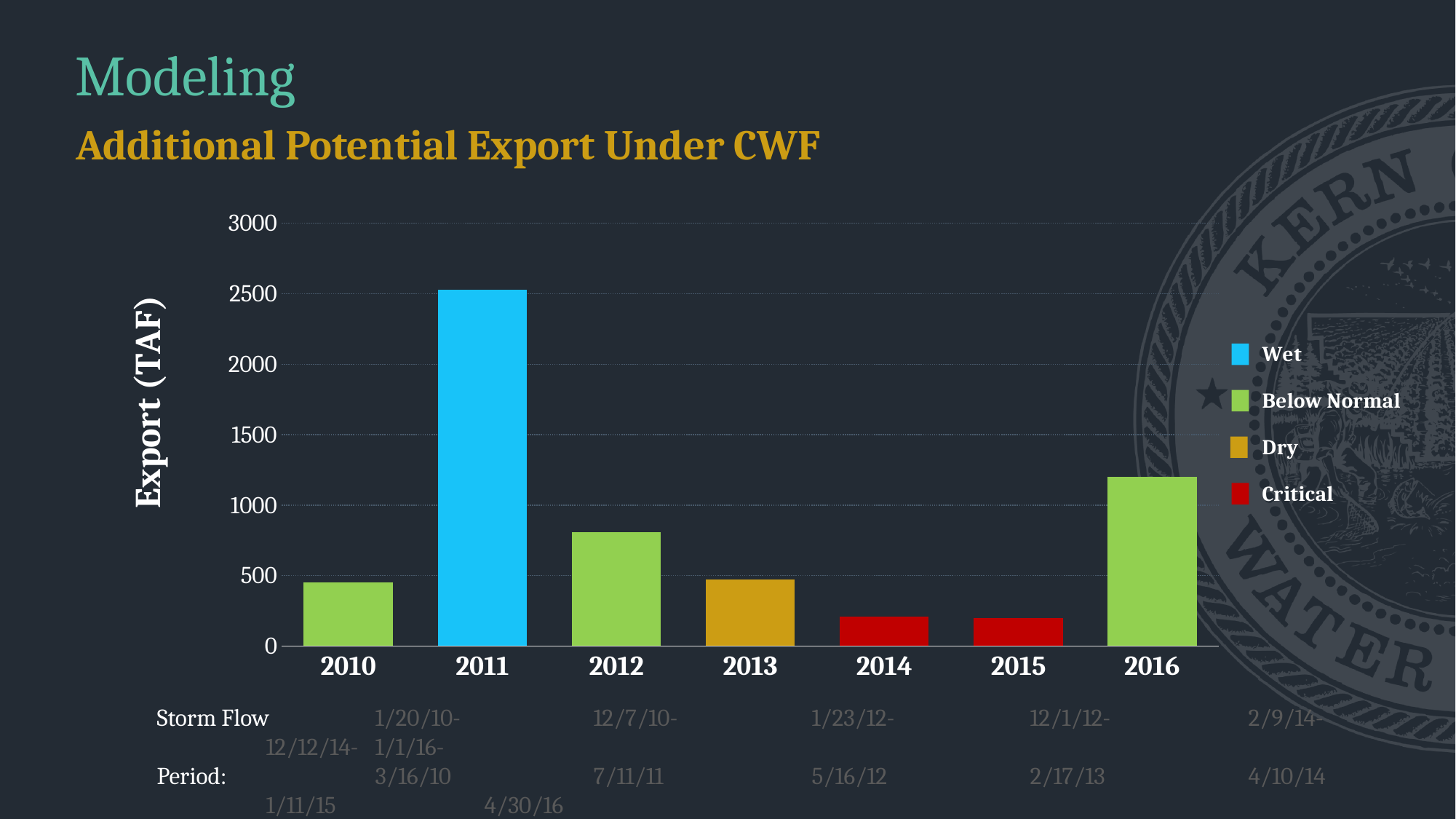
Which year has the larger export value, 2012 or 2016? 2016 Which year has the larger export value, 2013 or 2012? 2012 Which year has the highest export value in the chart? 2011 What kind of chart is shown on the slide? bar chart How many entries does the chart's legend list? 4 Is the export value for 2016 greater or less than 1000? greater What is the label on the chart's y axis? Export (TAF) According to the legend, which water year type does the blue bar for 2011 represent? Wet Is the export value for 2010 greater or less than 500? less How many years are shown on the x axis of the chart? 7 Is the export value for 2014 greater or less than 500? less